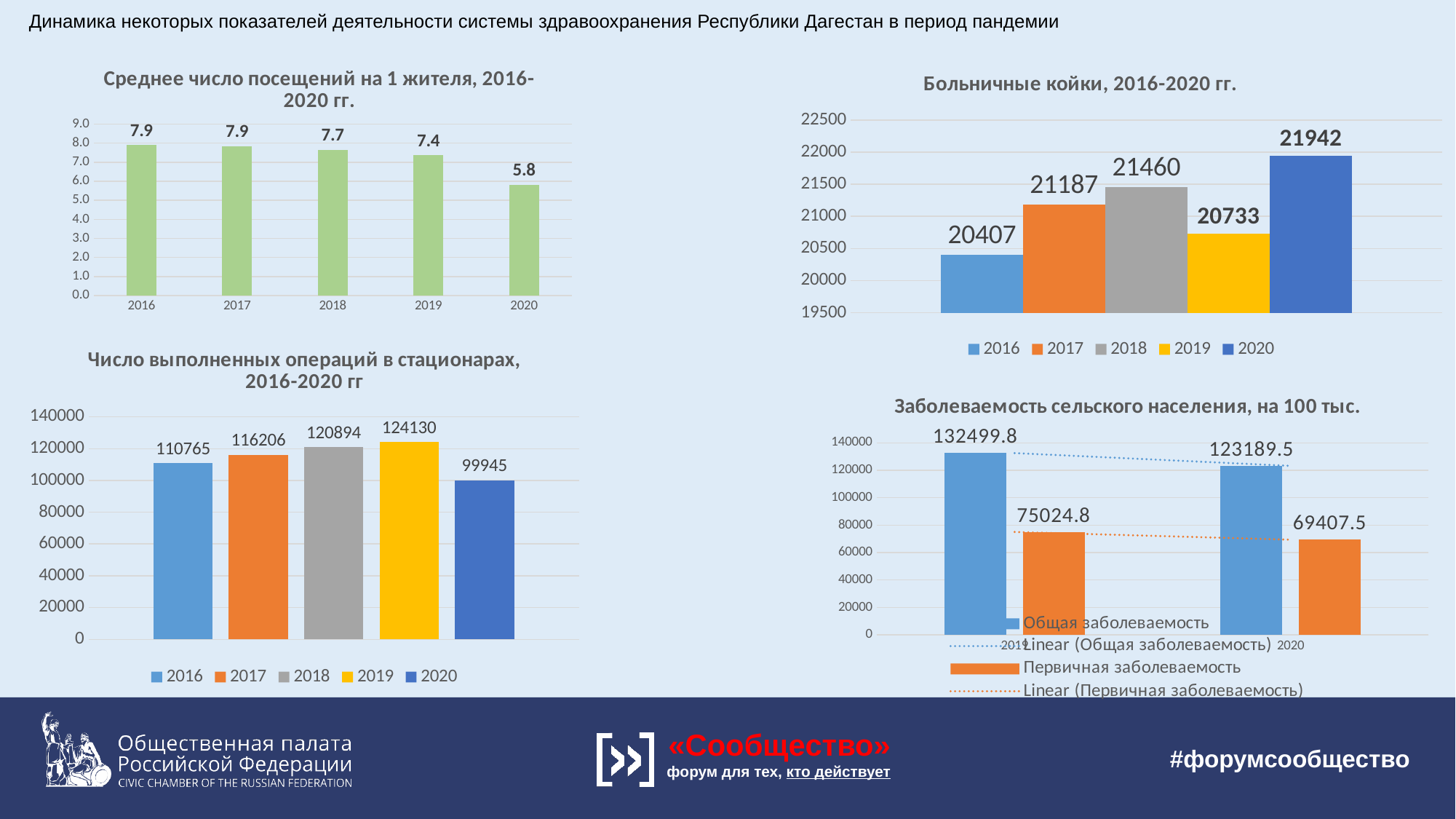
In the chart 'Заболеваемость сельского населения, на 100 тыс.', what is the value of 'Общая заболеваемость' for 2020? 123189.5 In the chart 'Среднее число посещений на 1 жителя, 2016-2020 гг.', what is the difference between the 2019 and 2020 values? 1.6 In the chart 'Число выполненных операций в стационарах, 2016-2020 гг', what is the value for 2019? 124130 In the chart 'Число выполненных операций в стационарах, 2016-2020 гг', what is the difference between the 2019 and 2020 values? 24185 In the chart 'Число выполненных операций в стационарах, 2016-2020 гг', how many years are shown? 5 What type of chart is 'Больничные койки, 2016-2020 гг.'? Bar chart In the chart 'Среднее число посещений на 1 жителя, 2016-2020 гг.', which year has the lowest value? 2020 In the chart 'Заболеваемость сельского населения, на 100 тыс.', what is the value of 'Первичная заболеваемость' for 2020? 69407.5 In the chart 'Больничные койки, 2016-2020 гг.', which is larger, the value for 2017 or the value for 2019? 2017 In the chart 'Среднее число посещений на 1 жителя, 2016-2020 гг.', what is the value for 2020? 5.8 In the chart 'Больничные койки, 2016-2020 гг.', which year has the highest value? 2020 In the chart 'Больничные койки, 2016-2020 гг.', what is the value for 2018? 21460